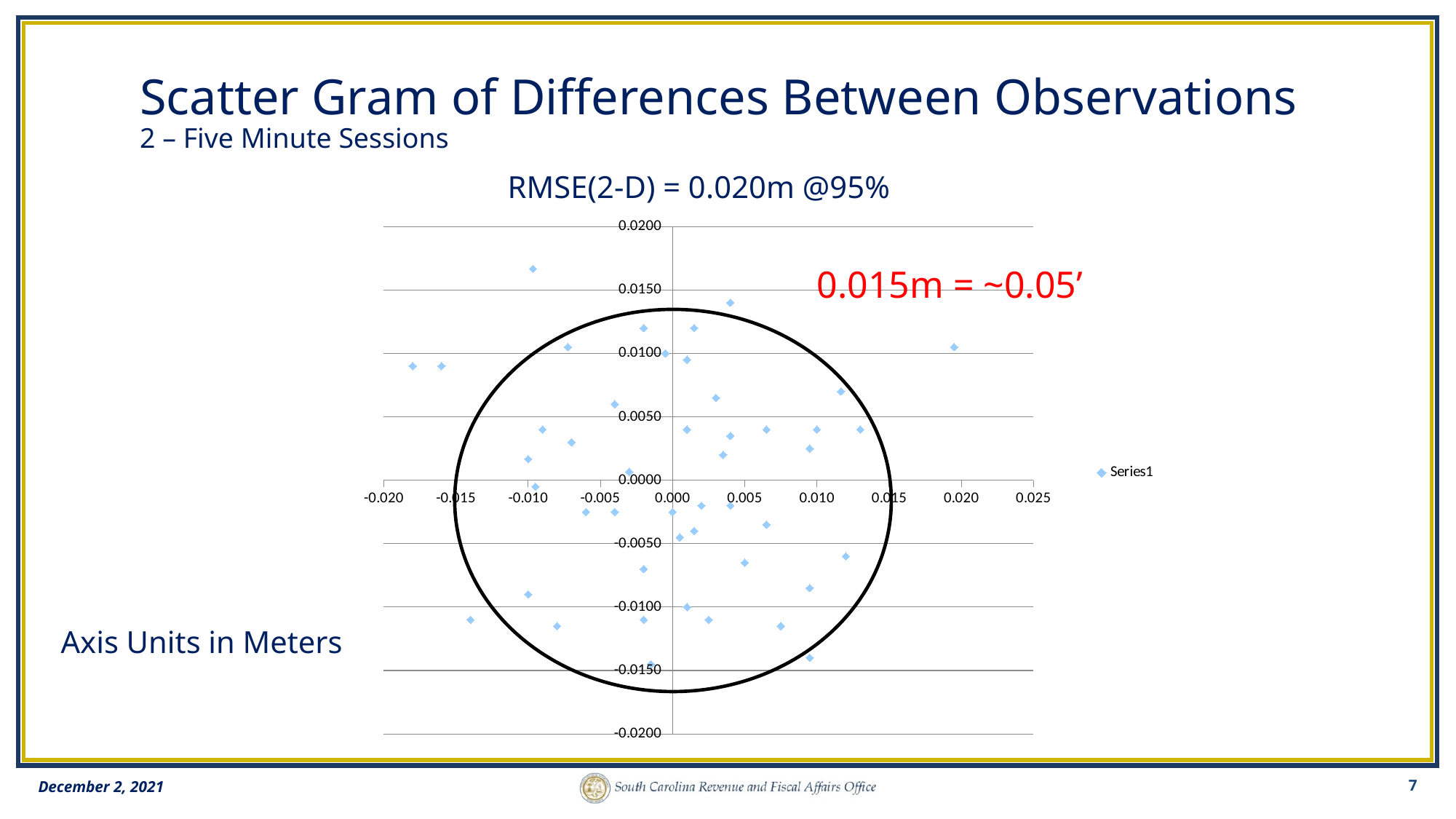
How many series does the legend list? 1 What is the title of the chart? RMSE(2-D) = 0.020m @95% Is the x value of the rightmost plotted point greater or less than 0.015? greater What is the name of the series shown in the legend? Series1 Is the y value of the highest plotted point greater or less than 0.0150? greater What kind of chart is shown on the slide? scatter chart Is the y value of the lowest plotted point greater or less than -0.0100? less